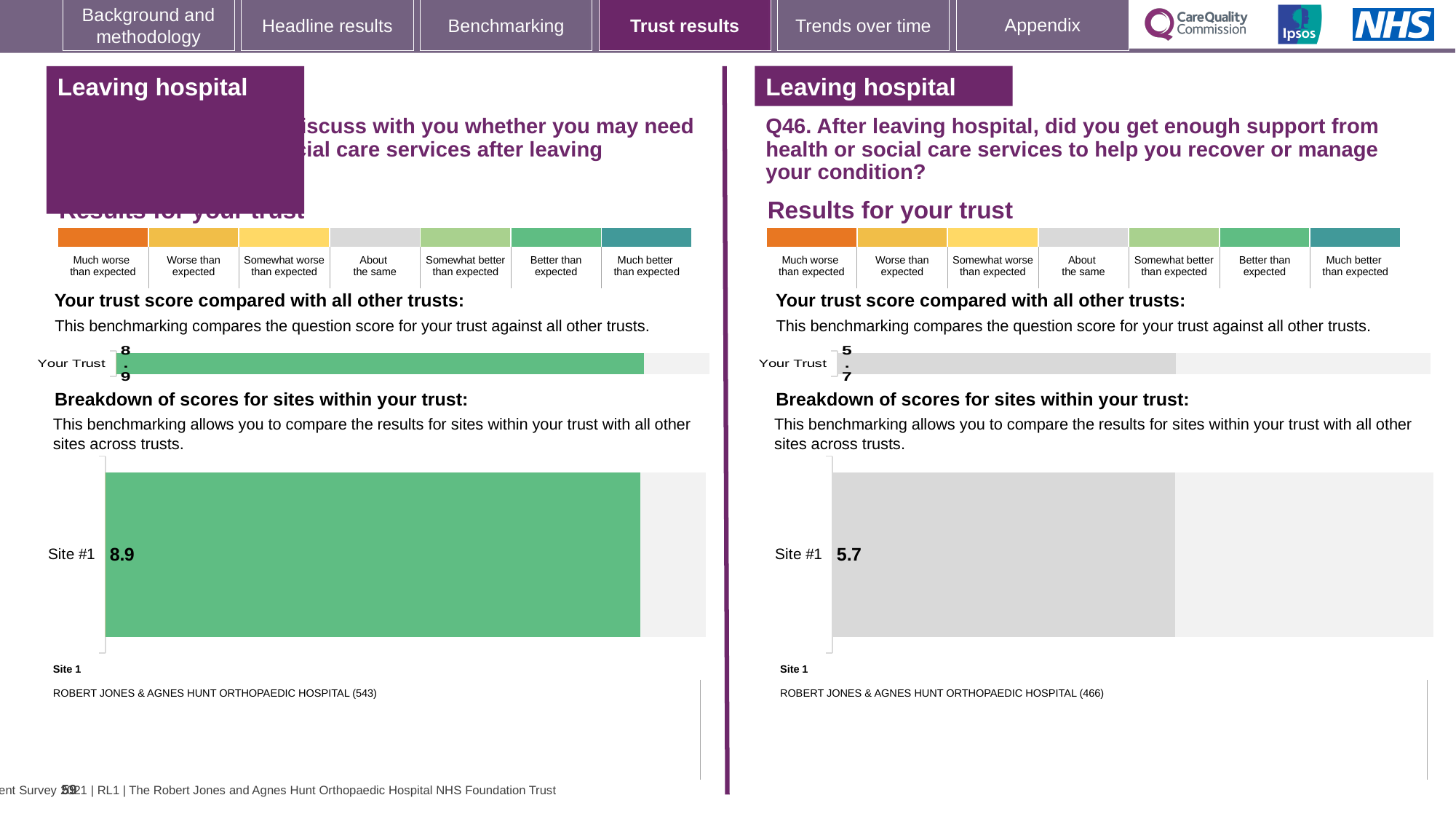
On the right half of the slide (Q46), what score is shown for Site #1 in the 'Breakdown of scores for sites within your trust' chart? 5.7 What is the difference between the Site #1 score on the left half of the slide and the Site #1 score on the right half (Q46)? 3.2 Which is larger: the Your Trust score on the left half of the slide or the Your Trust score on the right half (Q46)? Left half (8.9) How many sites are shown in the 'Breakdown of scores for sites within your trust' chart on the right half of the slide (Q46)? 1 What colour is the Your Trust bar on the right half of the slide (Q46)? Grey On the left half of the slide, what is the score shown for Your Trust in the 'Your trust score compared with all other trusts' chart? 8.9 On the right half of the slide (Q46), what is the score shown for Your Trust in the 'Your trust score compared with all other trusts' chart? 5.7 What is the name of the site listed as Site 1 on the right half of the slide (Q46)? ROBERT JONES & AGNES HUNT ORTHOPAEDIC HOSPITAL (466) What type of chart is used to show the Site #1 score on the left half of the slide? Bar chart On the left half of the slide, what score is shown for Site #1 in the 'Breakdown of scores for sites within your trust' chart? 8.9 What colour is the Site #1 bar on the left half of the slide? Green On the right half of the slide (Q46), is the Site #1 score greater or less than the Site #1 score on the left half of the slide? less